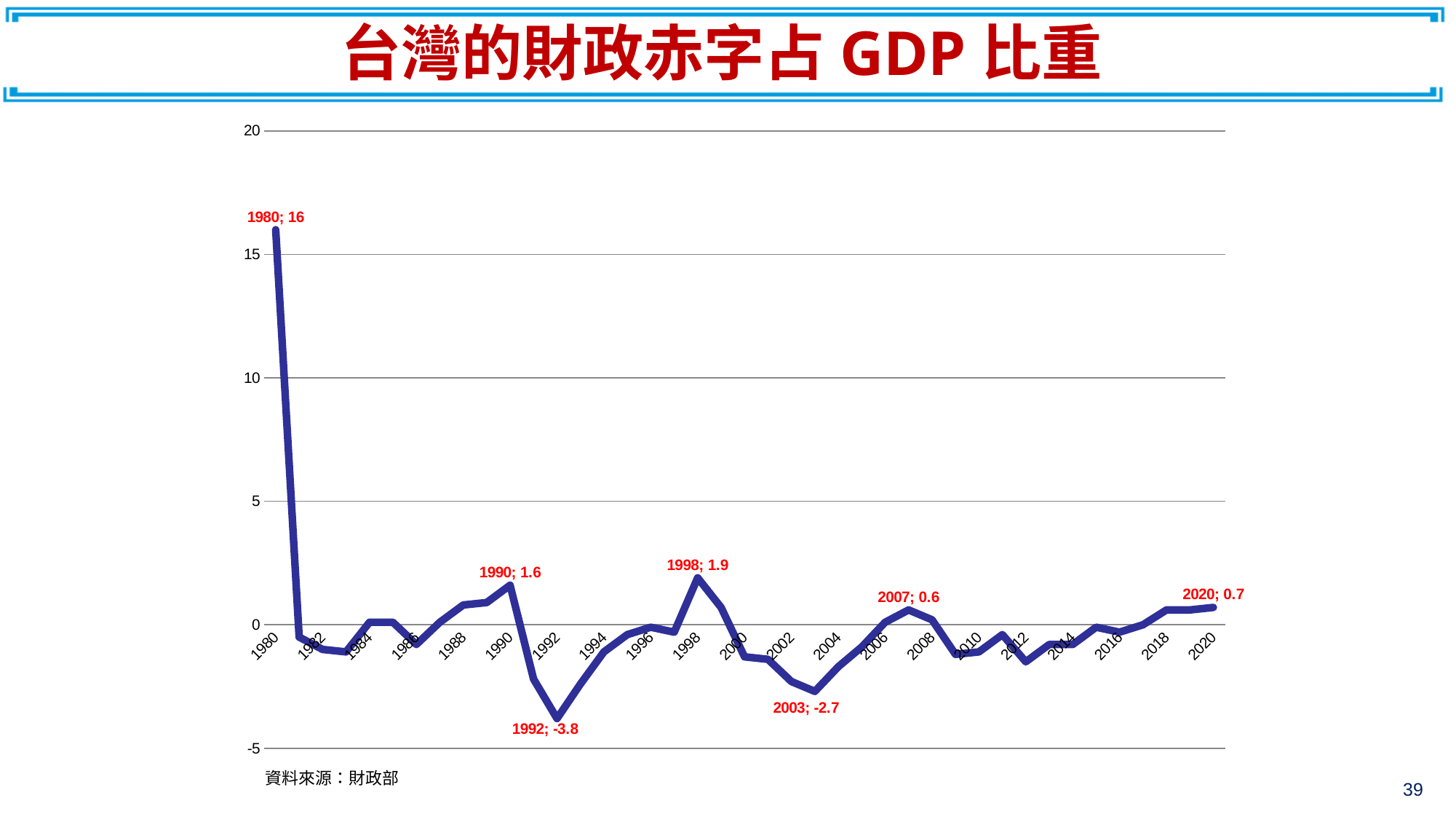
What is the value for 1980? 16 What is the value for 2003? -2.7 What is the value for 1992? -3.8 Which is larger, the value for 2007 or the value for 2020? 2020 Which year has the lowest value on the chart? 1992 What is the title of the chart? 台灣的財政赤字占 GDP 比重 What is the value for 2020? 0.7 What is the value for 1998? 1.9 Which year has the highest value on the chart? 1980 What is the difference between the values for 1998 and 1990? 0.3 What type of chart is shown on the slide? line chart Is the value for 1984 greater or less than 5? less